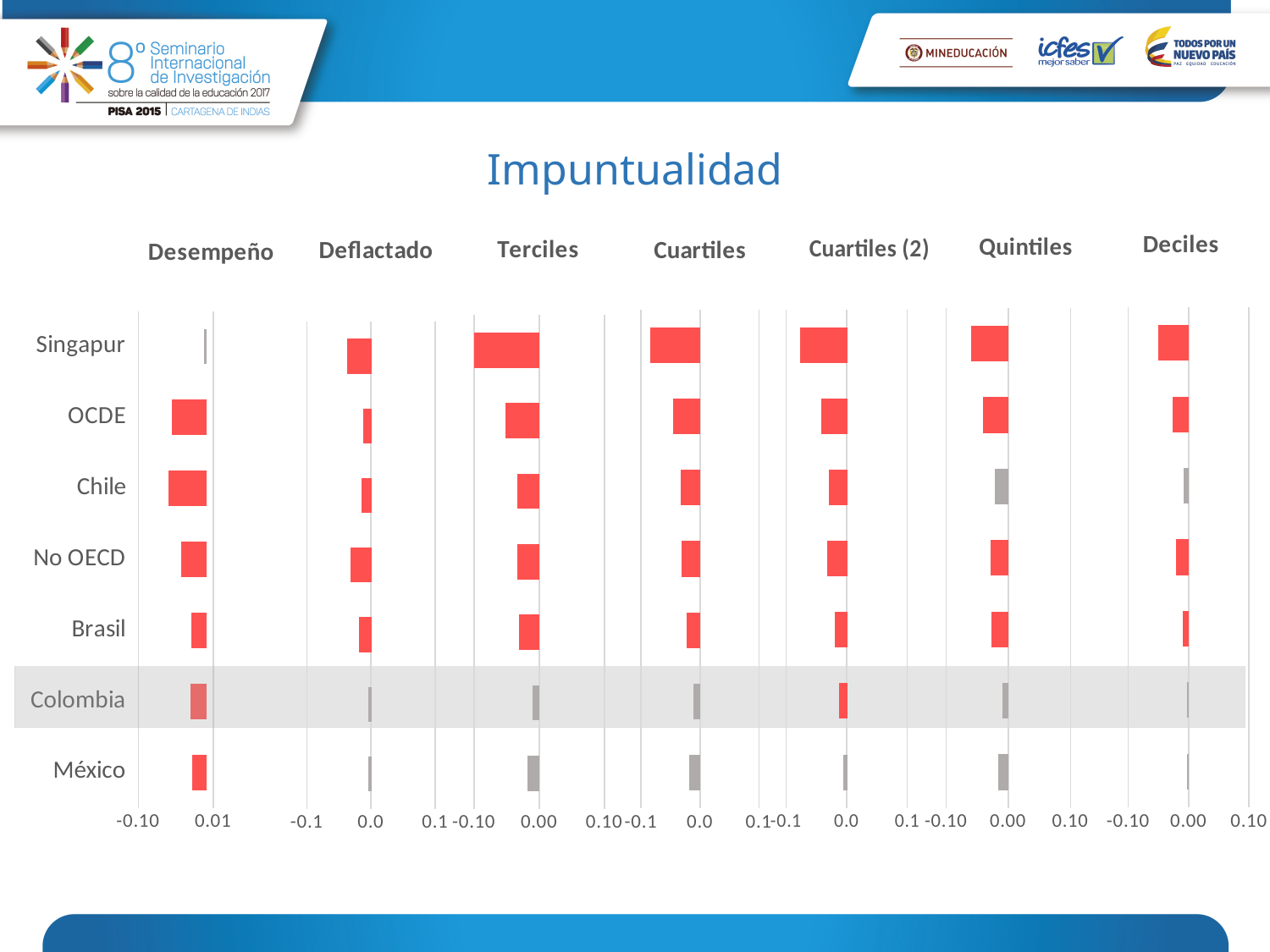
In the Deflactado chart, which has the longer bar, Singapur or OCDE? Singapur In the Terciles chart, which category has the lowest (most negative) value? Singapur How many categories (rows) are listed on the left of the charts? 7 In the Desempeño chart, is the value for OCDE greater or less than 0.01? less In the Quintiles chart, which category has the longest bar? Singapur How many separate chart panels are shown on the slide? 7 In the Cuartiles (2) chart, which has the longer bar, Singapur or Brasil? Singapur What kind of chart is used for the Desempeño panel? bar chart What is the title of the slide above the charts? Impuntualidad In the Terciles chart, is the value for Singapur greater or less than 0.00? less Which category's row is highlighted with a gray background across all the charts? Colombia In the Cuartiles chart, which category has the bar extending furthest from zero? Singapur